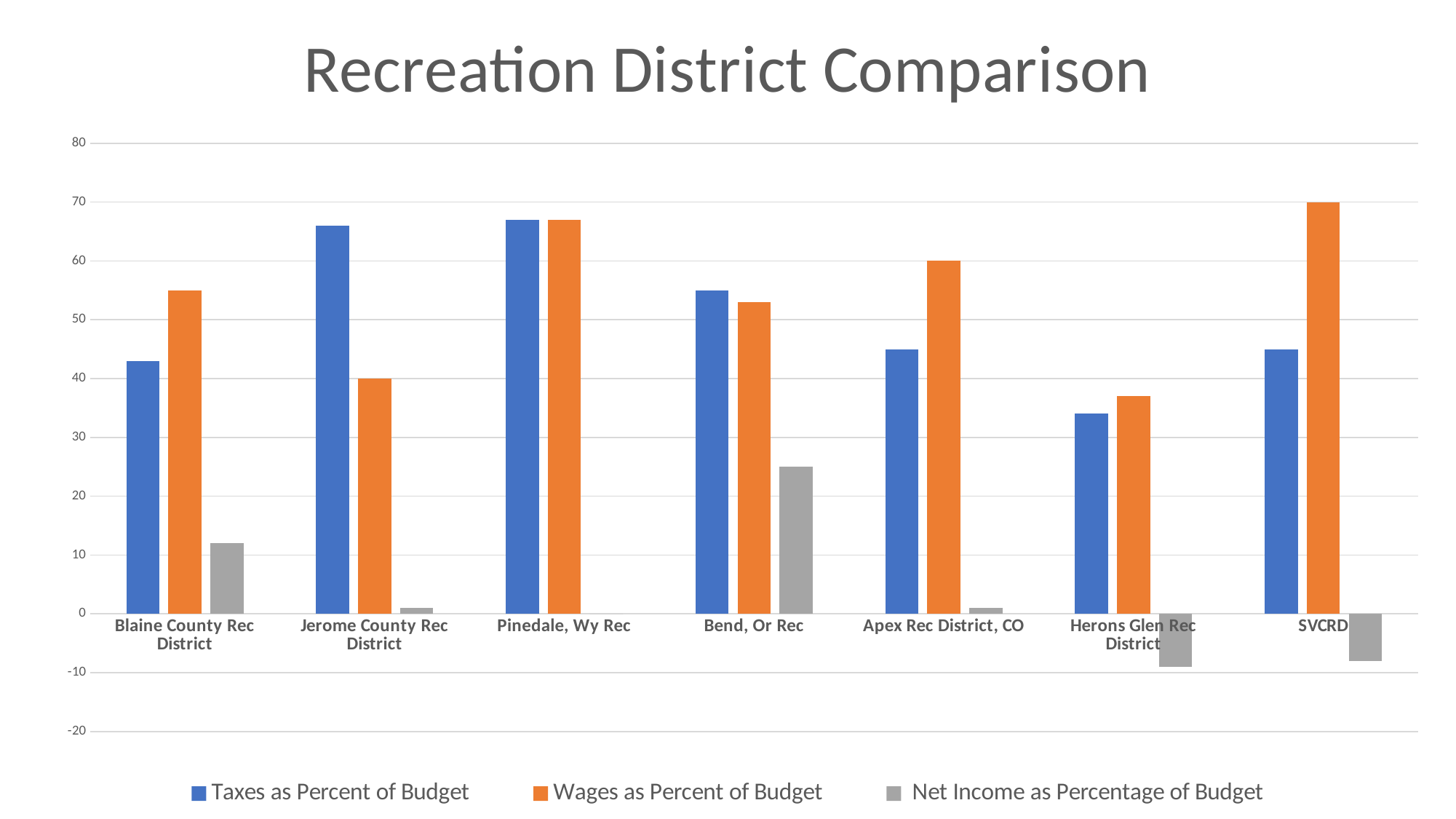
Is the value of Net Income as Percentage of Budget for Herons Glen Rec District greater or less than 0? less For Blaine County Rec District, which is larger: Taxes as Percent of Budget or Wages as Percent of Budget? Wages as Percent of Budget What is the value of Wages as Percent of Budget for SVCRD? 70 How many recreation districts are compared on the x axis? 7 What is the title of the chart? Recreation District Comparison How many series does the legend list? 3 Is the value of Taxes as Percent of Budget for Blaine County Rec District greater or less than 40? greater Which district has the highest Net Income as Percentage of Budget? Bend, Or Rec What is the value of Wages as Percent of Budget for Apex Rec District, CO? 60 What kind of chart is shown on the slide? bar chart Which district has the highest Wages as Percent of Budget? SVCRD What is the value of Wages as Percent of Budget for Jerome County Rec District? 40